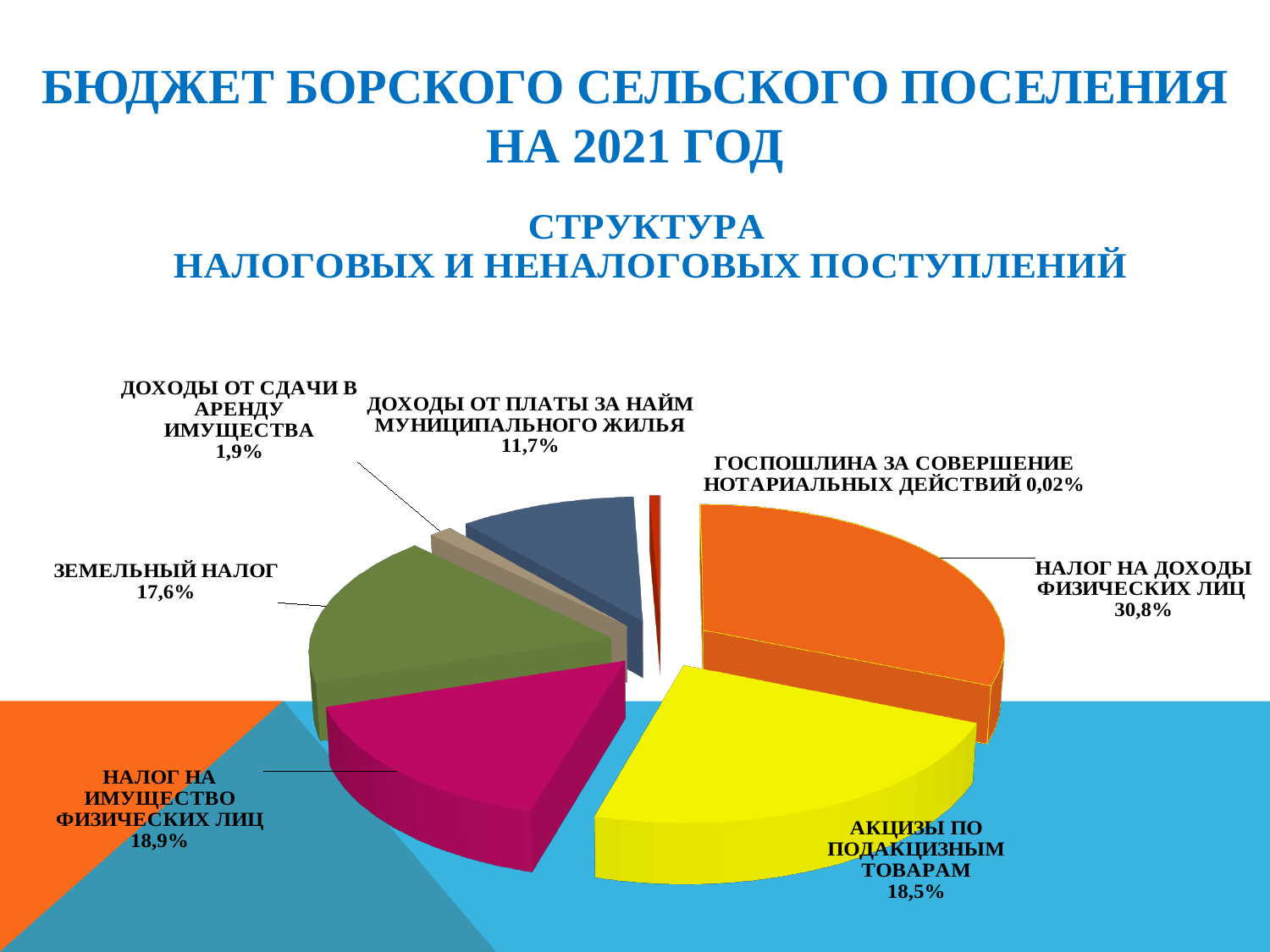
What share is shown for ДОХОДЫ ОТ ПЛАТЫ ЗА НАЙМ МУНИЦИПАЛЬНОГО ЖИЛЬЯ? 11,7% What colour is the slice for АКЦИЗЫ ПО ПОДАКЦИЗНЫМ ТОВАРАМ? Yellow Which is larger: the share for НАЛОГ НА ИМУЩЕСТВО ФИЗИЧЕСКИХ ЛИЦ or the share for ДОХОДЫ ОТ ПЛАТЫ ЗА НАЙМ МУНИЦИПАЛЬНОГО ЖИЛЬЯ? НАЛОГ НА ИМУЩЕСТВО ФИЗИЧЕСКИХ ЛИЦ Which category has the largest share of the pie? НАЛОГ НА ДОХОДЫ ФИЗИЧЕСКИХ ЛИЦ What share is shown for ГОСПОШЛИНА ЗА СОВЕРШЕНИЕ НОТАРИАЛЬНЫХ ДЕЙСТВИЙ? 0,02% What share is shown for ЗЕМЕЛЬНЫЙ НАЛОГ? 17,6% What share is shown for АКЦИЗЫ ПО ПОДАКЦИЗНЫМ ТОВАРАМ? 18,5% What share of the pie does НАЛОГ НА ДОХОДЫ ФИЗИЧЕСКИХ ЛИЦ have? 30,8% Which category has the smallest share of the pie? ГОСПОШЛИНА ЗА СОВЕРШЕНИЕ НОТАРИАЛЬНЫХ ДЕЙСТВИЙ What kind of chart is shown on the slide? Pie chart What is the difference in percentage points between НАЛОГ НА ДОХОДЫ ФИЗИЧЕСКИХ ЛИЦ and ЗЕМЕЛЬНЫЙ НАЛОГ? 13,2